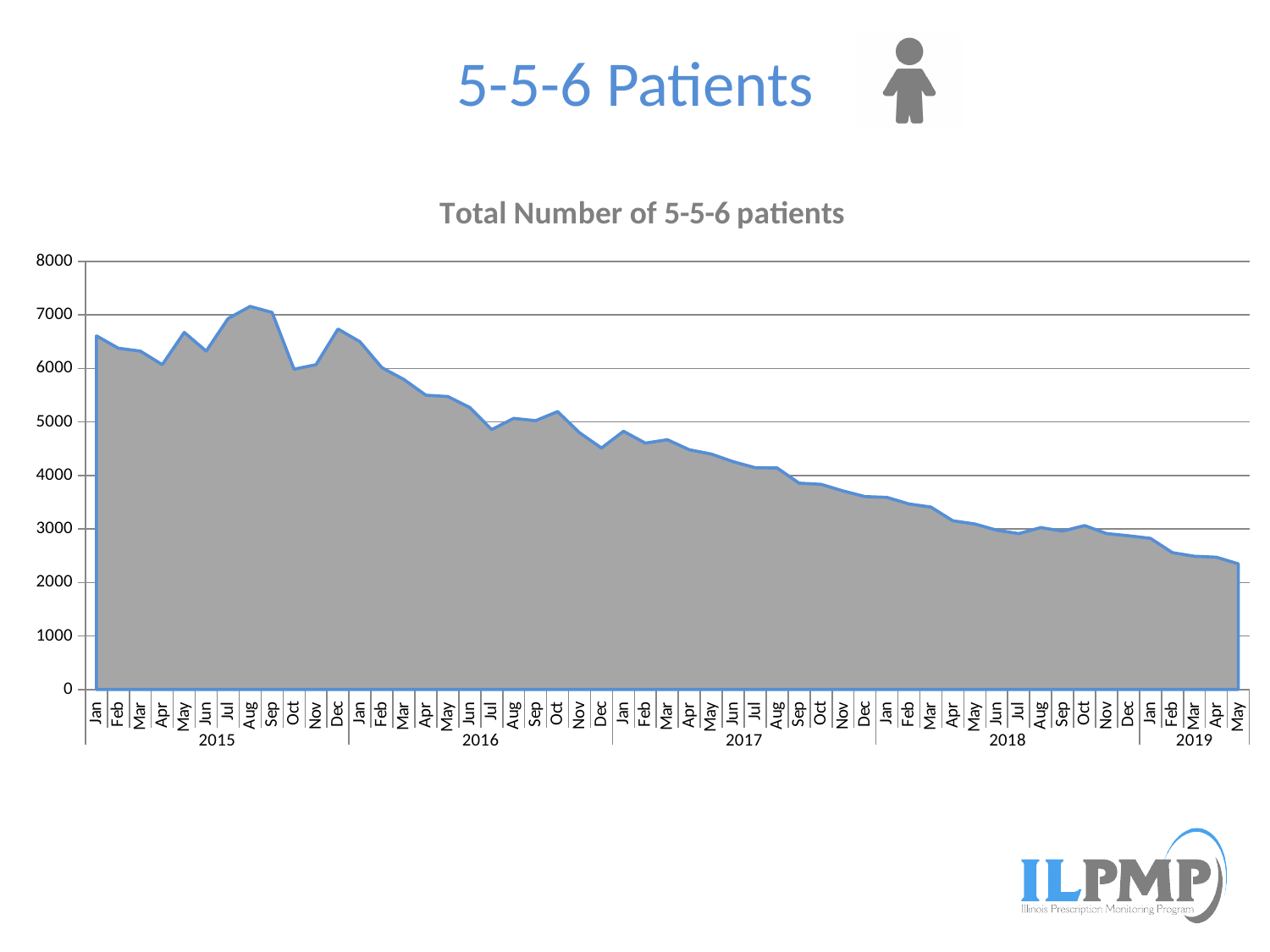
Which month has the lowest value in the chart? May 2019 Is the value for Jan 2017 greater or less than 5000? less Overall, do the values rise or fall from Jan 2015 to May 2019? Fall Which is larger, the value for Jan 2016 or the value for Jan 2019? Jan 2016 Is the value for Aug 2015 greater or less than 7000? greater Is the value for Jan 2015 greater or less than 6000? greater How many monthly data points are plotted in the chart? 53 What is the title of the chart? Total Number of 5-5-6 patients What kind of chart is shown on the slide? Area chart In which year does the chart reach its highest value? 2015